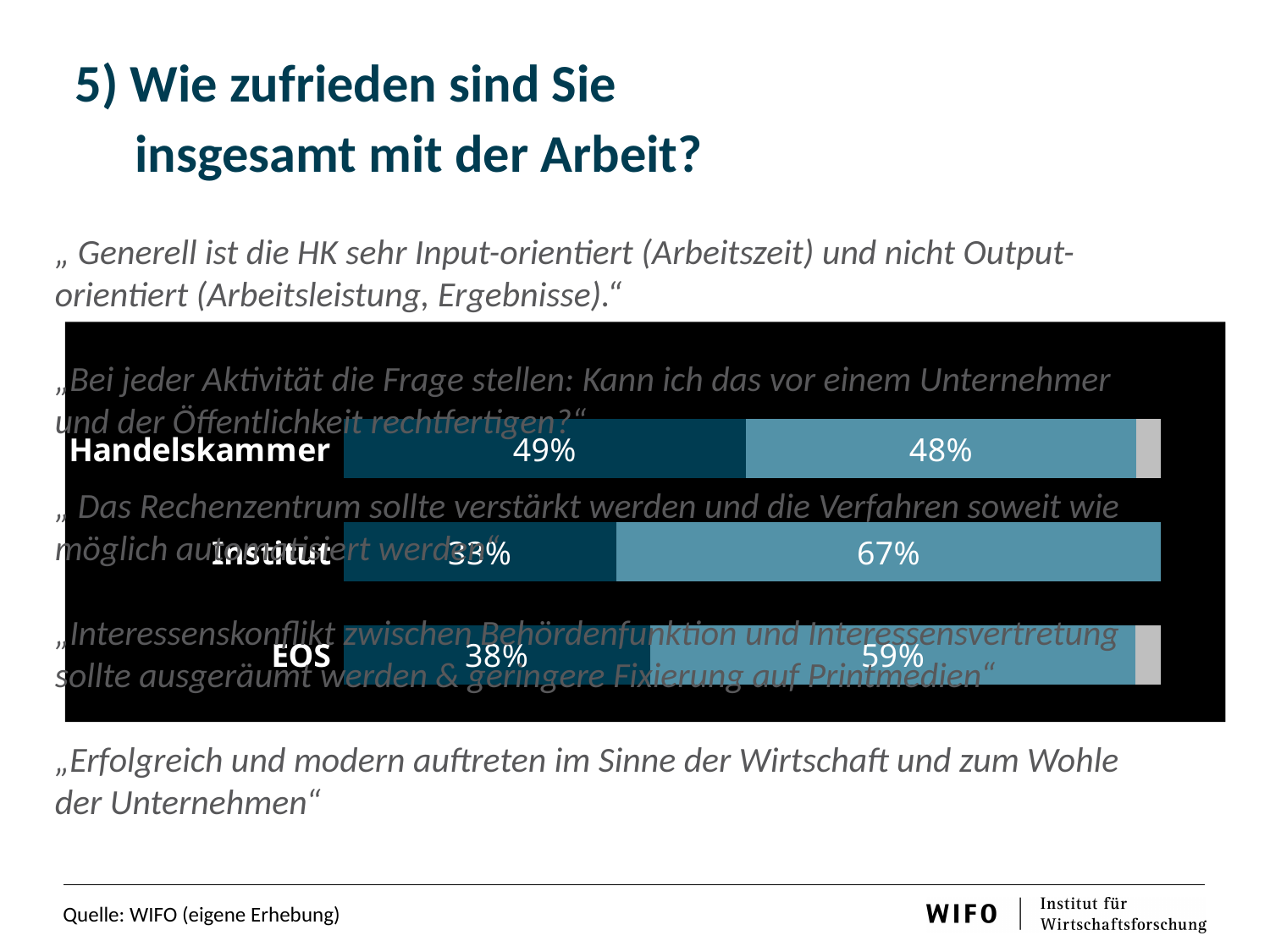
Which category has the largest lighter blue segment? Institut How many categories are shown in the chart? 3 What is the value of the lighter blue segment for EOS? 59% What is the value of the lighter blue segment for Institut? 67% What is the value of the dark blue segment for Handelskammer? 49% What is the difference between the lighter blue and dark blue segments for Institut? 34 percentage points Which category has the largest dark blue segment? Handelskammer What is the total of the two labelled segments for Institut? 100% What kind of chart is shown on the slide? Stacked bar chart Is the dark blue segment larger for Handelskammer or for EOS? Handelskammer What is the value of the dark blue segment for EOS? 38% Which category has the smallest dark blue segment? Institut